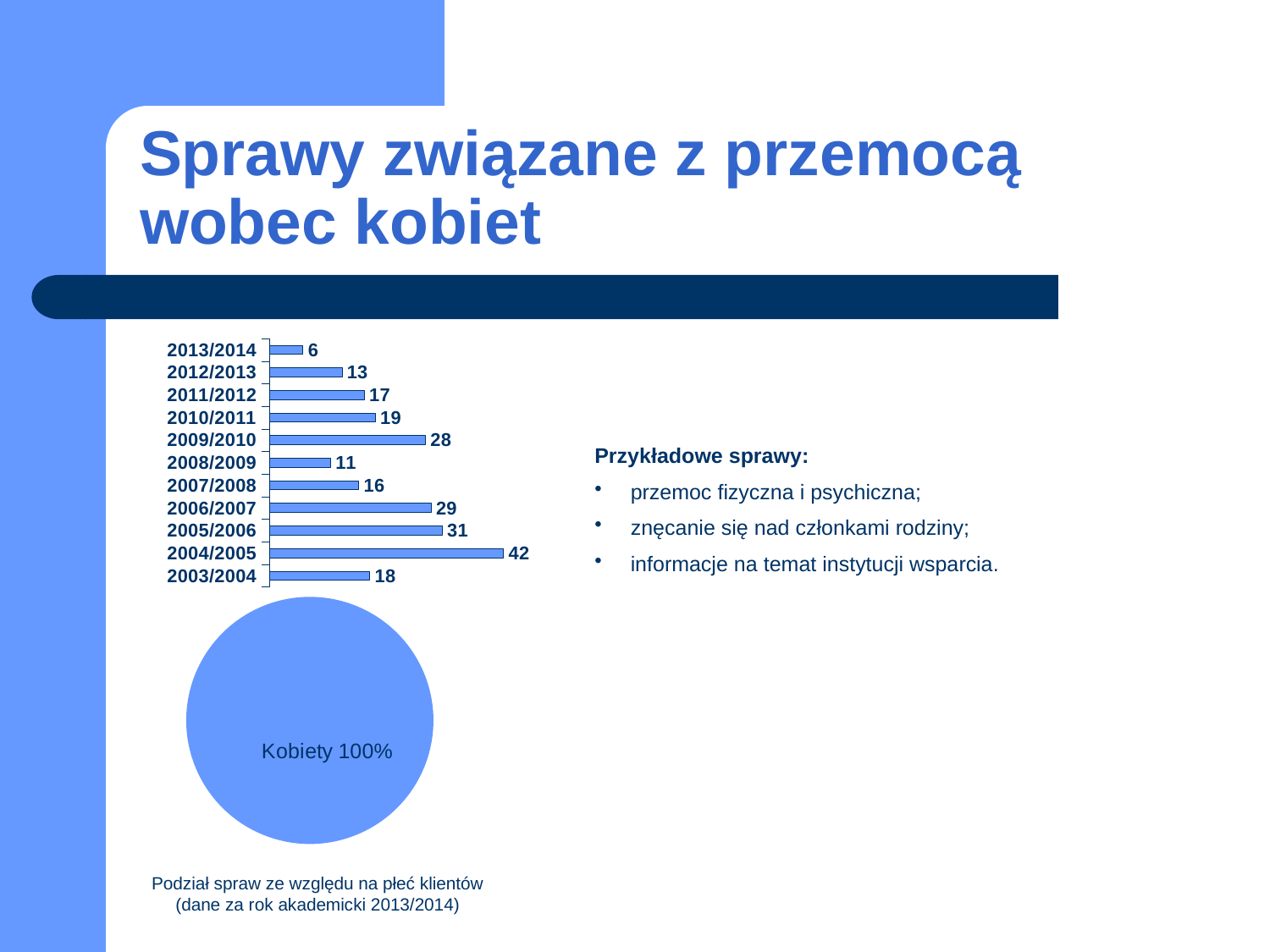
What kind of chart is the chart at the bottom of the slide? Pie chart What kind of chart is the chart at the top of the slide? Bar chart In the bar chart at the top of the slide, what is the value for 2004/2005? 42 In the bar chart at the top of the slide, what is the value for 2009/2010? 28 In the bar chart at the top of the slide, what is the difference between the values for 2004/2005 and 2003/2004? 24 In the bar chart at the top of the slide, which is larger: the value for 2005/2006 or the value for 2006/2007? 2005/2006 In the bar chart at the top of the slide, what is the difference between the values for 2012/2013 and 2013/2014? 7 In the bar chart at the top of the slide, which academic year has the lowest value? 2013/2014 In the bar chart at the top of the slide, what is the value for 2013/2014? 6 In the bar chart at the top of the slide, how many academic years are shown? 11 In the bar chart at the top of the slide, which academic year has the highest value? 2004/2005 In the pie chart at the bottom of the slide, what share does Kobiety have? 100%